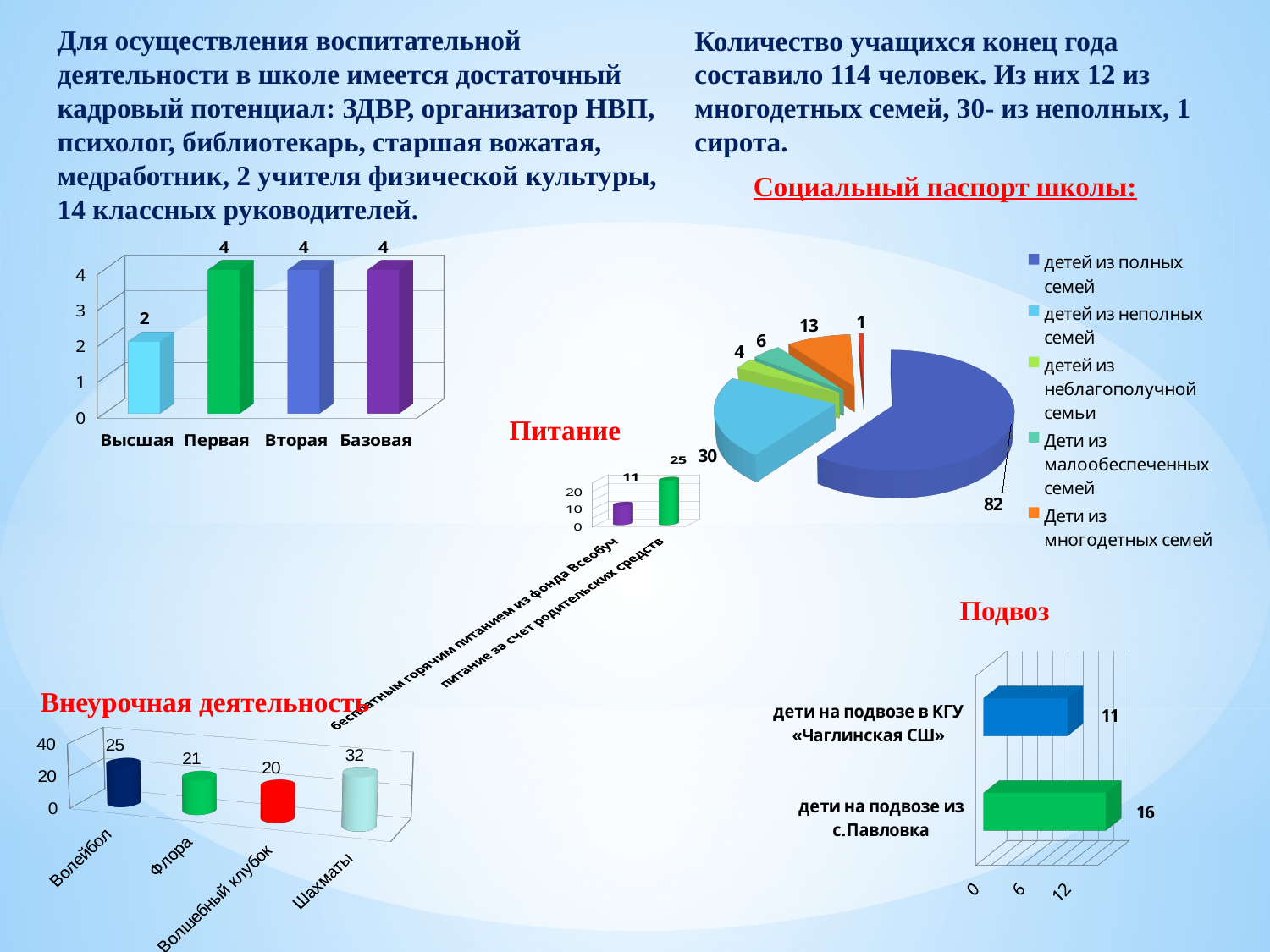
How many entries does the legend of the Социальный паспорт школы pie chart list? 5 In the Социальный паспорт школы pie chart, what is the value for детей из полных семей? 82 In the Социальный паспорт школы pie chart, what is the value for Дети из многодетных семей? 13 In the Подвоз chart, which is larger: дети на подвозе в КГУ «Чаглинская СШ» or дети на подвозе из с.Павловка? дети на подвозе из с.Павловка In the top-left bar chart, what is the value for Высшая? 2 In the Питание chart, what is the value for питание за счет родительских средств? 25 In the top-left bar chart, which category has the lowest value? Высшая In the Внеурочная деятельность chart, which category has the highest value? Шахматы What kind of chart is the Подвоз chart? bar chart In the top-left bar chart, how many categories are shown? 4 In the Социальный паспорт школы pie chart, what is the difference between детей из полных семей and детей из неполных семей? 52 In the Внеурочная деятельность chart, what is the value for Флора? 21